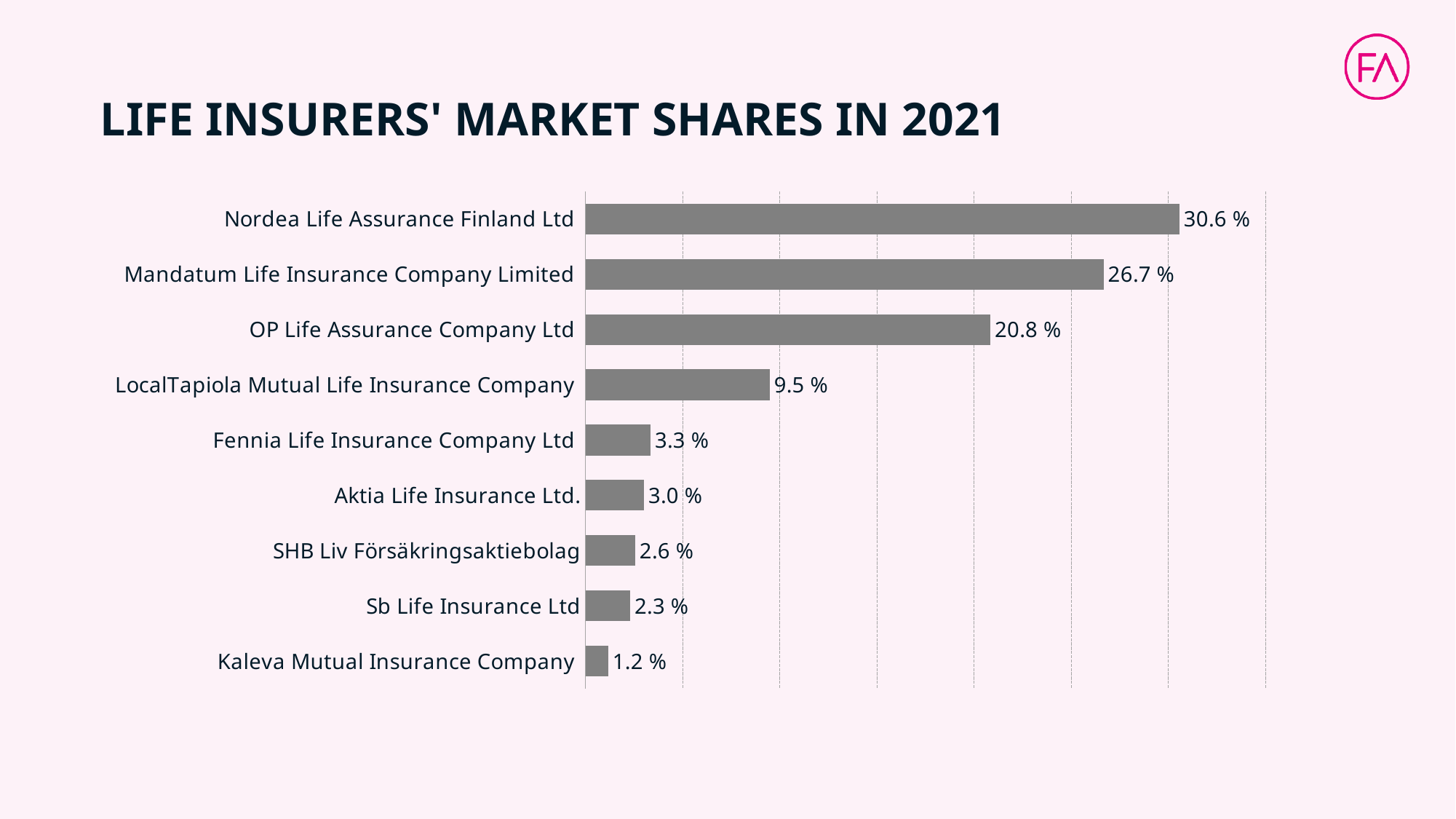
What is the difference in market share between Nordea Life Assurance Finland Ltd and Mandatum Life Insurance Company Limited? 3.9 % Which company has the highest market share? Nordea Life Assurance Finland Ltd Which has a larger market share, Fennia Life Insurance Company Ltd or Sb Life Insurance Ltd? Fennia Life Insurance Company Ltd What kind of chart is shown on the slide? Bar chart Which company has the lowest market share? Kaleva Mutual Insurance Company What is the title of the chart? LIFE INSURERS' MARKET SHARES IN 2021 What is the market share of Nordea Life Assurance Finland Ltd? 30.6 % What is the difference in market share between OP Life Assurance Company Ltd and LocalTapiola Mutual Life Insurance Company? 11.3 % What is the market share of SHB Liv Försäkringsaktiebolag? 2.6 % What is the market share of Aktia Life Insurance Ltd.? 3.0 % What is the market share of LocalTapiola Mutual Life Insurance Company? 9.5 % How many companies are shown in the chart? 9